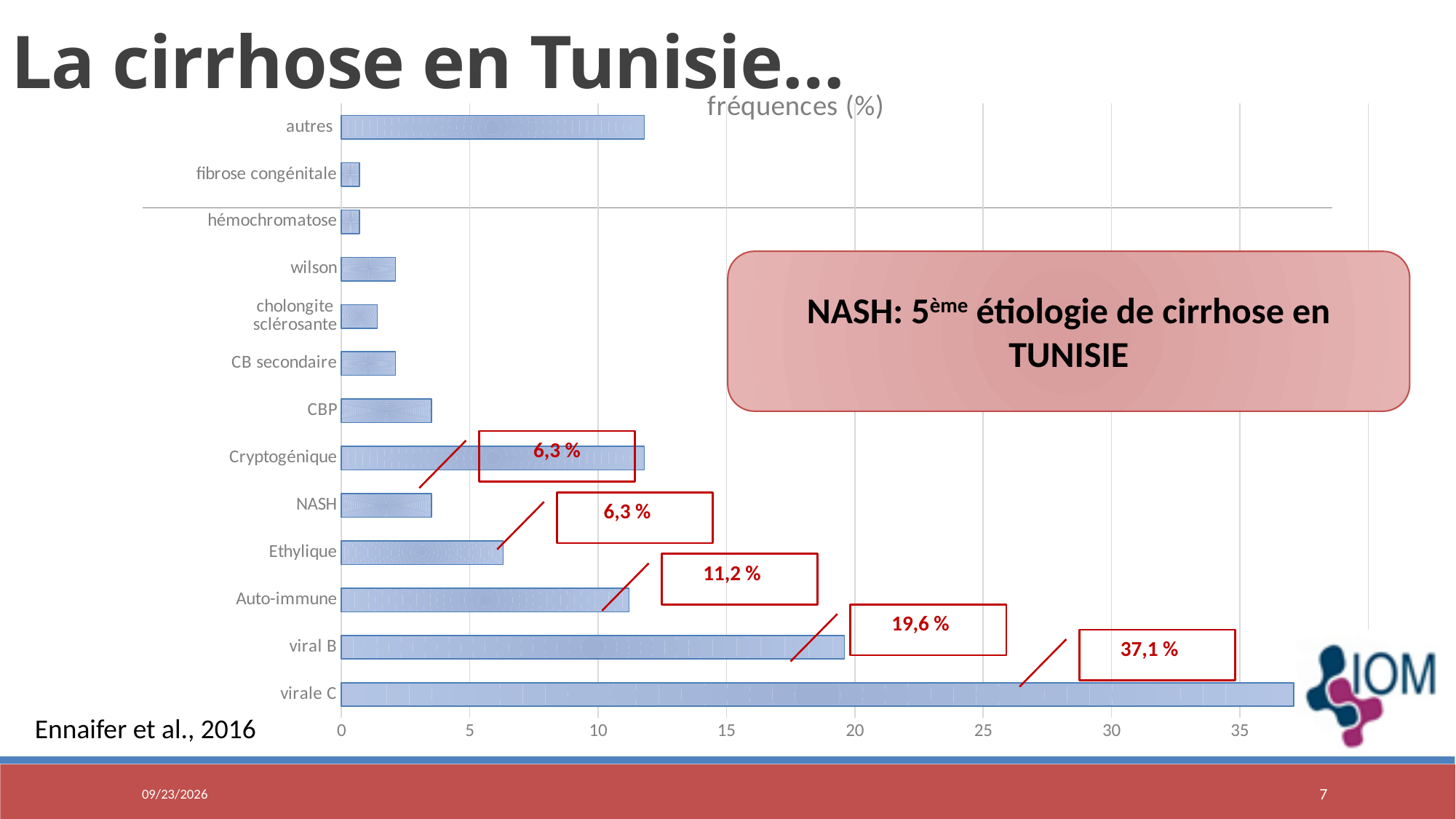
What is the frequency labelled for virale C? 37,1 % What is the frequency labelled for Auto-immune? 11,2 % What is the frequency labelled for viral B? 19,6 % Which category has the highest frequency? virale C What is the title of the chart? fréquences (%) What is the difference between the frequencies of virale C and viral B? 17,5 % Is the value for CBP greater or less than 5? less Which has a higher frequency, viral B or Auto-immune? viral B What is the frequency labelled for Ethylique? 6,3 % Is the value for autres greater or less than 10? greater How many categories (etiologies) are plotted in the chart? 13 What type of chart is shown on the slide? bar chart